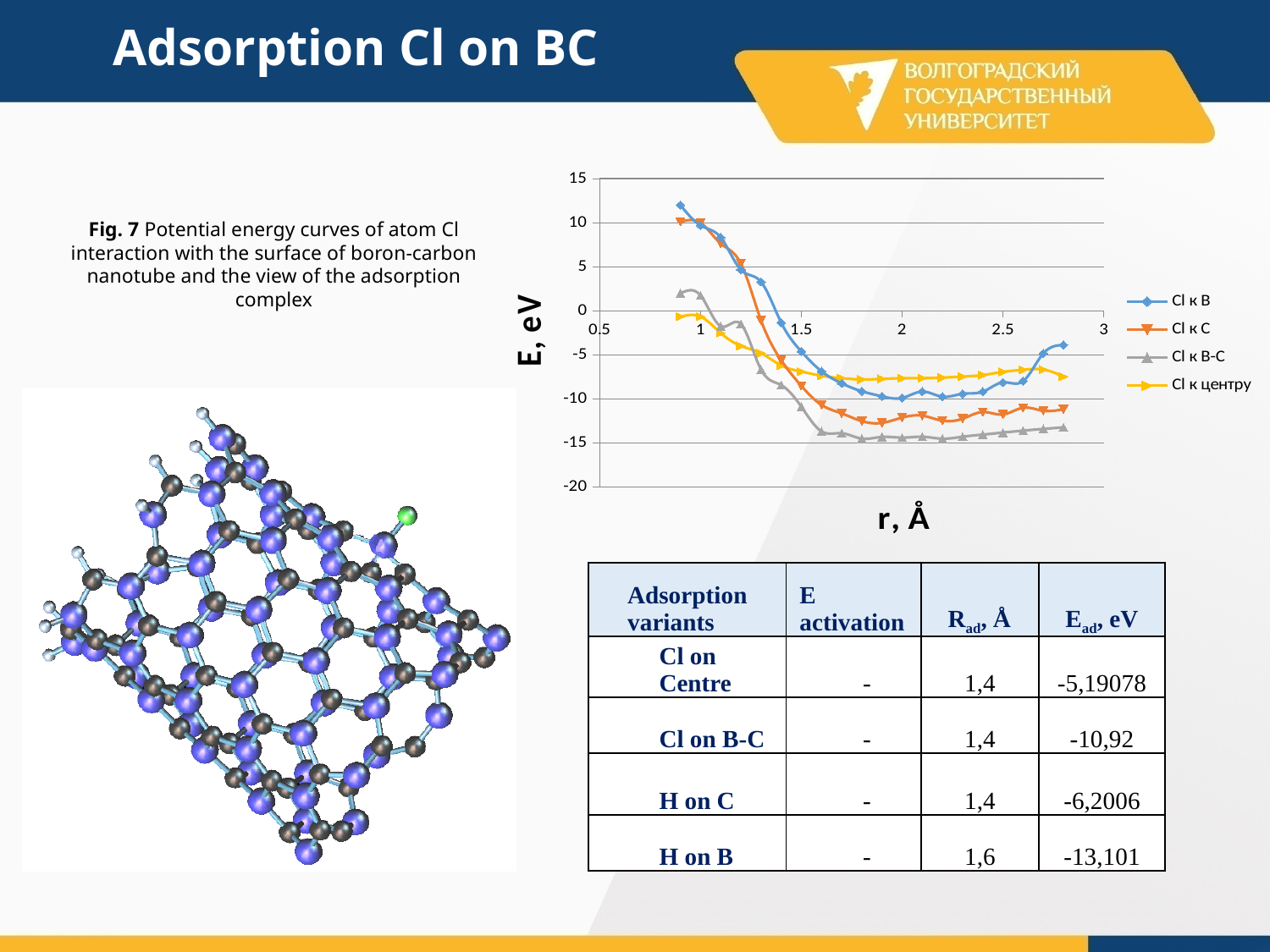
Is the value of the Cl к центру series at r = 2 greater or less than -10? greater What is the label of the vertical axis of the chart? E, eV Is the value of the Cl к B series at r = 1 greater or less than 5? greater Which series reaches the lowest energy value on the chart? Cl к B-C Is the value of the Cl к B-C series at r = 2 greater or less than -10? less Does the Cl к B-C series rise or fall as r increases from 1 to 2? fall At r = 2, which series has the larger value: Cl к центру or Cl к B-C? Cl к центру What is the label of the horizontal axis of the chart? r, Å How many series does the chart legend list? 4 What is the lowest tick value shown on the vertical axis of the chart? -20 What kind of chart is shown on the slide? line chart